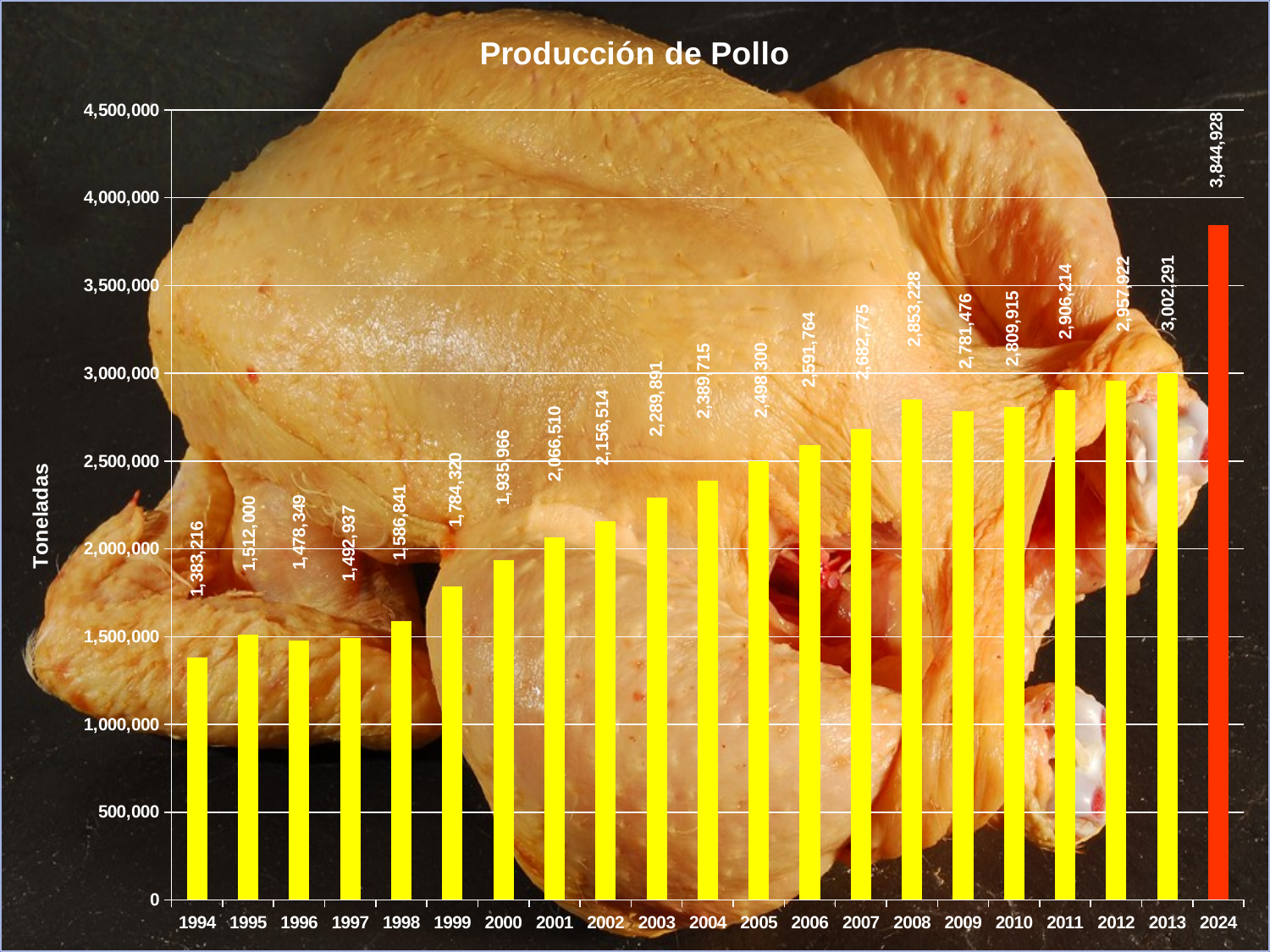
How many years (bars) are shown in the chart? 21 What is the chicken production value for 2013? 3,002,291 What is the chicken production value for 2024? 3,844,928 What is the difference in production between 2024 and 2013? 842,637 What is the chicken production value for 1994? 1,383,216 What is the difference in production between 2013 and 1994? 1,619,075 Which year had higher production, 2008 or 2009? 2008 What is the label on the vertical axis? Toneladas Which year has the highest chicken production? 2024 What is the title of the chart? Producción de Pollo Which year has the lowest chicken production? 1994 What type of chart is shown on the slide? bar chart